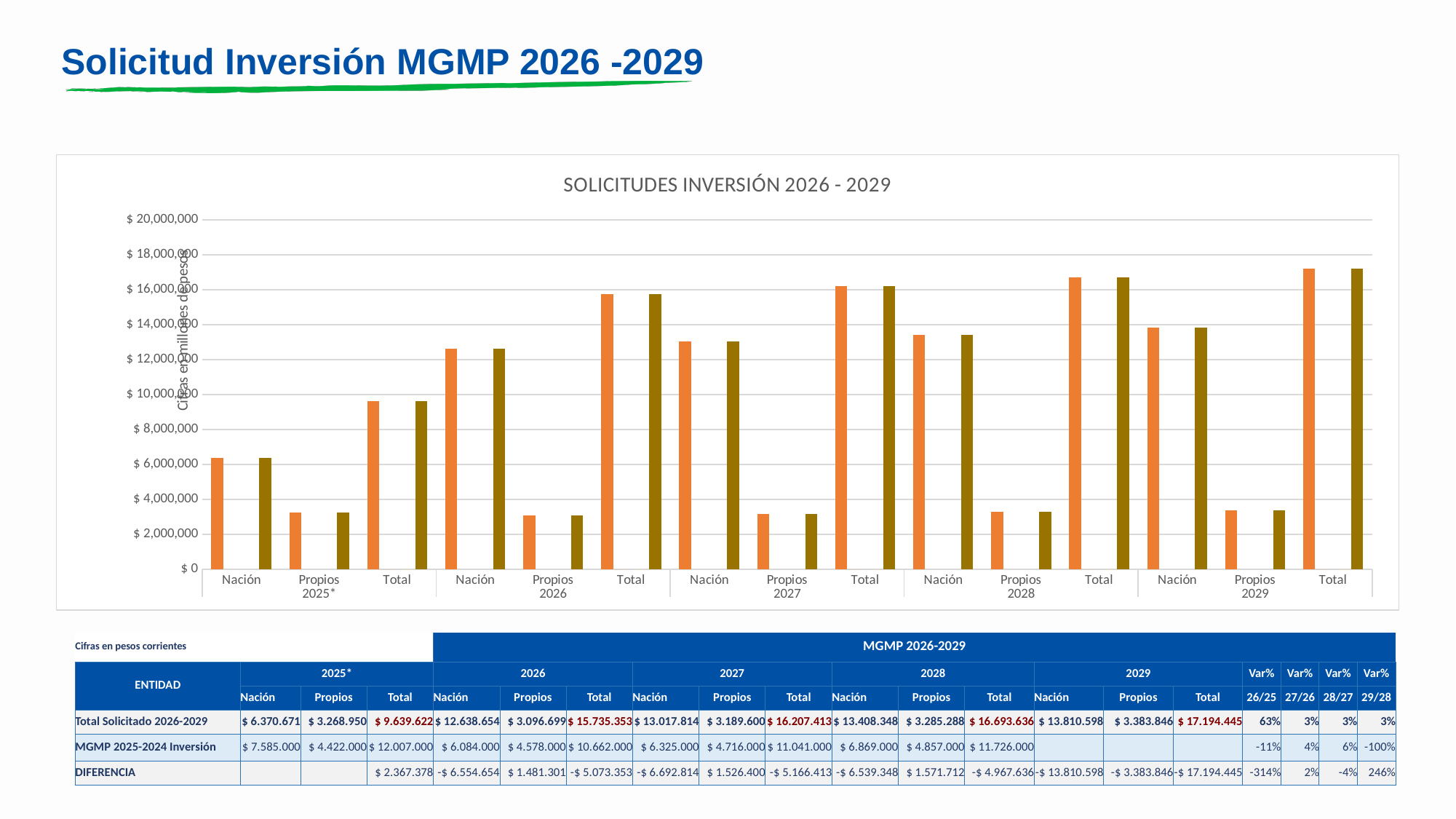
What kind of chart is shown on the slide? Bar chart Among the Nación categories, which year has the lowest bars? 2025* Which is larger, the value for Nación 2029 or the value for Total 2025*? Nación 2029 Is the value for Total 2028 greater or less than $ 16,000,000? greater What is the title of the chart? SOLICITUDES INVERSIÓN 2026 - 2029 Is the value for Nación 2025* greater or less than $ 8,000,000? less How many year groups are shown along the x axis of the chart? 5 Is the value for Propios 2029 greater or less than $ 4,000,000? less Which category has the tallest bars in the chart? Total 2029 Do the Total values rise or fall from 2025* to 2029? Rise Which is larger, the value for Total 2027 or the value for Total 2025*? Total 2027